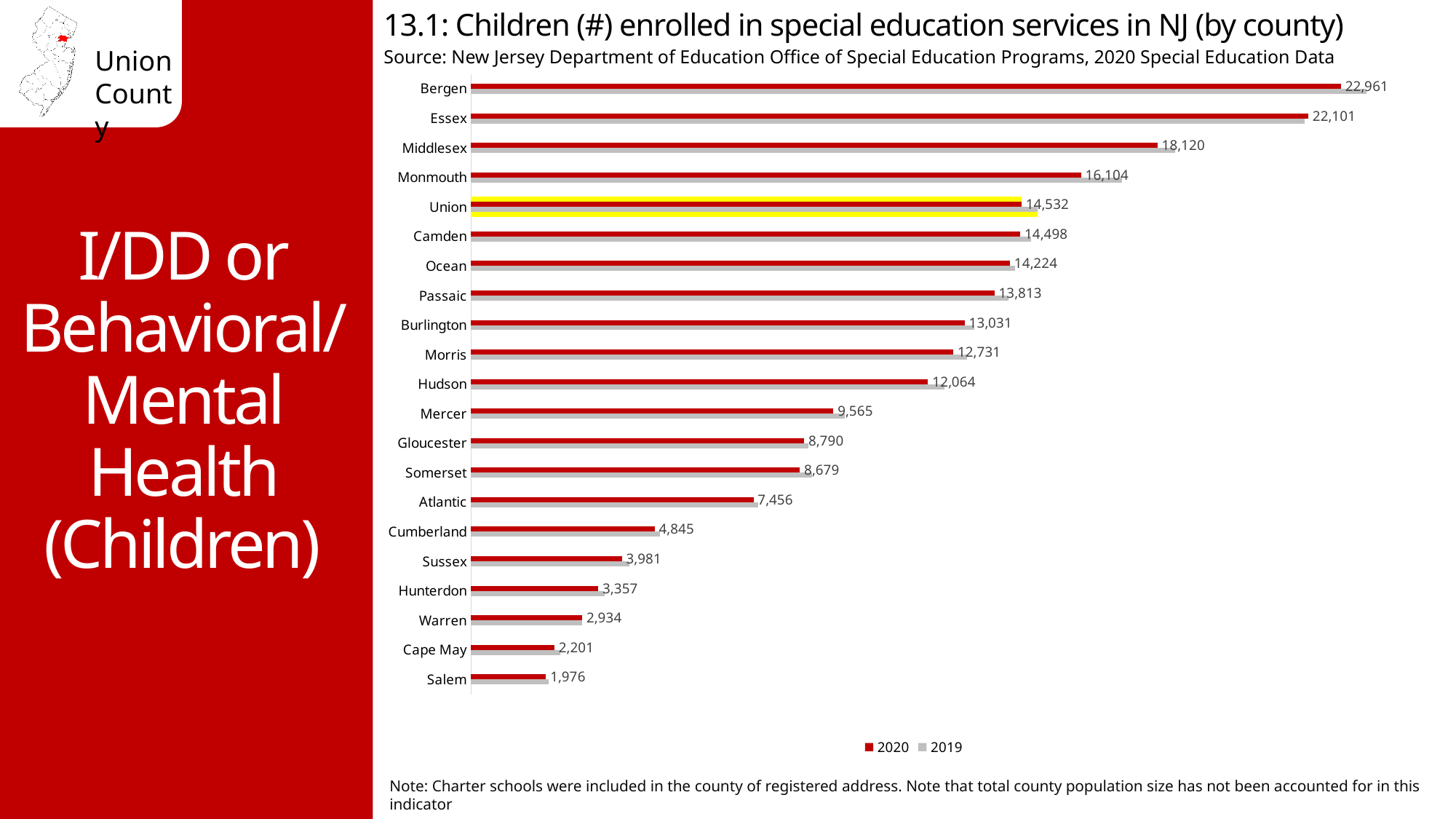
Which county's bars are highlighted in yellow? Union Which county has a larger 2020 value, Mercer or Gloucester? Mercer How many counties are shown in the chart? 21 Which county has the lowest 2020 value? Salem What is the difference between the 2020 values for Bergen and Essex? 860 What is the difference between the 2020 values for Middlesex and Monmouth? 2,016 What is the 2020 value for Union county? 14,532 What type of chart is shown on the slide? Bar chart Which county has the highest 2020 value? Bergen What is the 2020 value shown for Cumberland county? 4,845 How many children were enrolled in special education services in Bergen county in 2020? 22,961 How many series does the legend list? 2